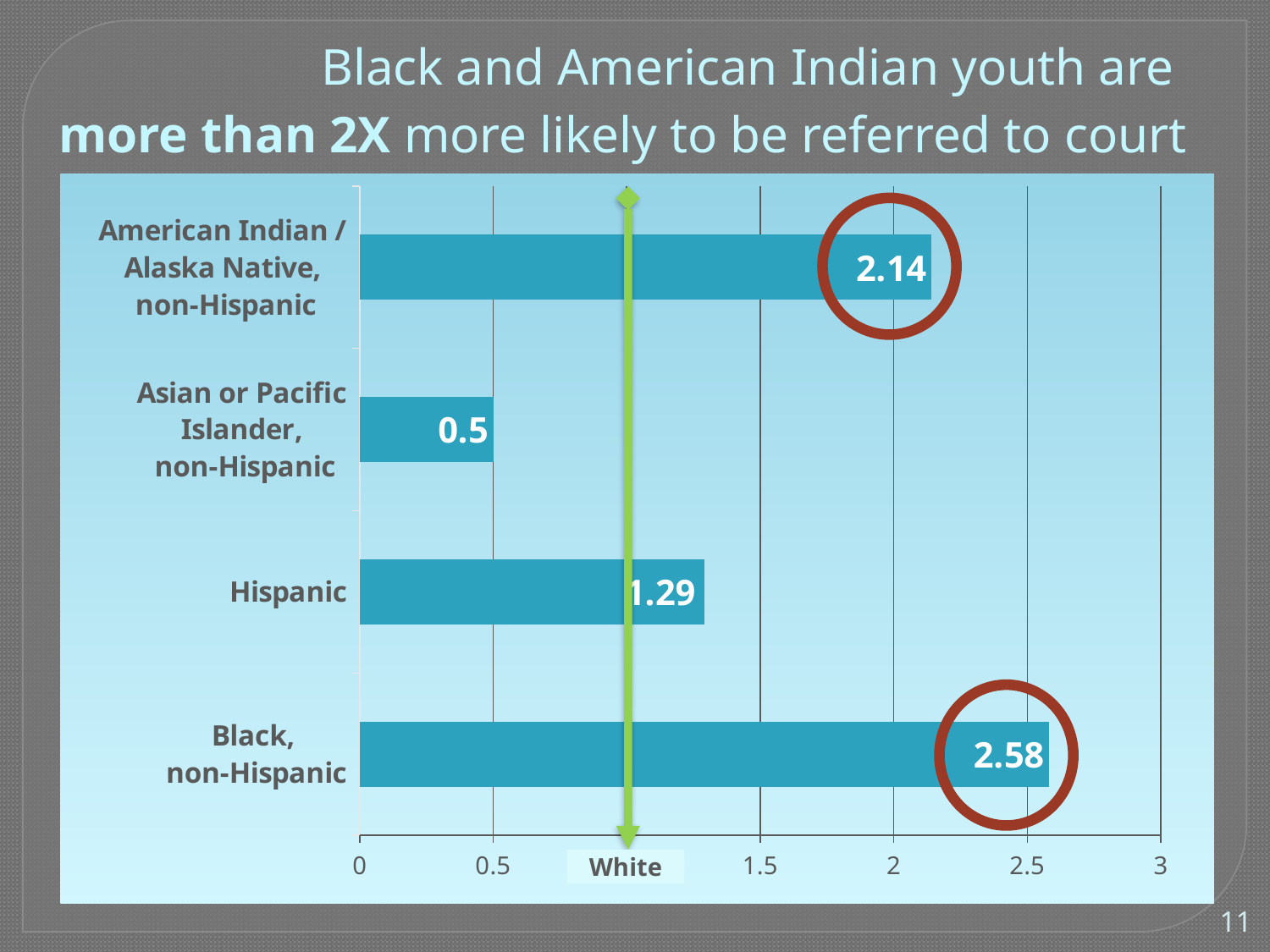
Which category has the highest value? Black, non-Hispanic Which is larger, the value for Hispanic or the value for Asian or Pacific Islander, non-Hispanic? Hispanic What is the value for American Indian / Alaska Native, non-Hispanic? 2.14 What is the value for Asian or Pacific Islander, non-Hispanic? 0.5 What label is shown at the green vertical reference line on the x axis? White What is the value for Black, non-Hispanic? 2.58 Is the value for Black, non-Hispanic greater or less than 2.5? greater Which category has the lowest value? Asian or Pacific Islander, non-Hispanic What is the difference between the values for Black, non-Hispanic and American Indian / Alaska Native, non-Hispanic? 0.44 What is the value for Hispanic? 1.29 How many categories are shown in the chart? 4 What kind of chart is shown on the slide? bar chart